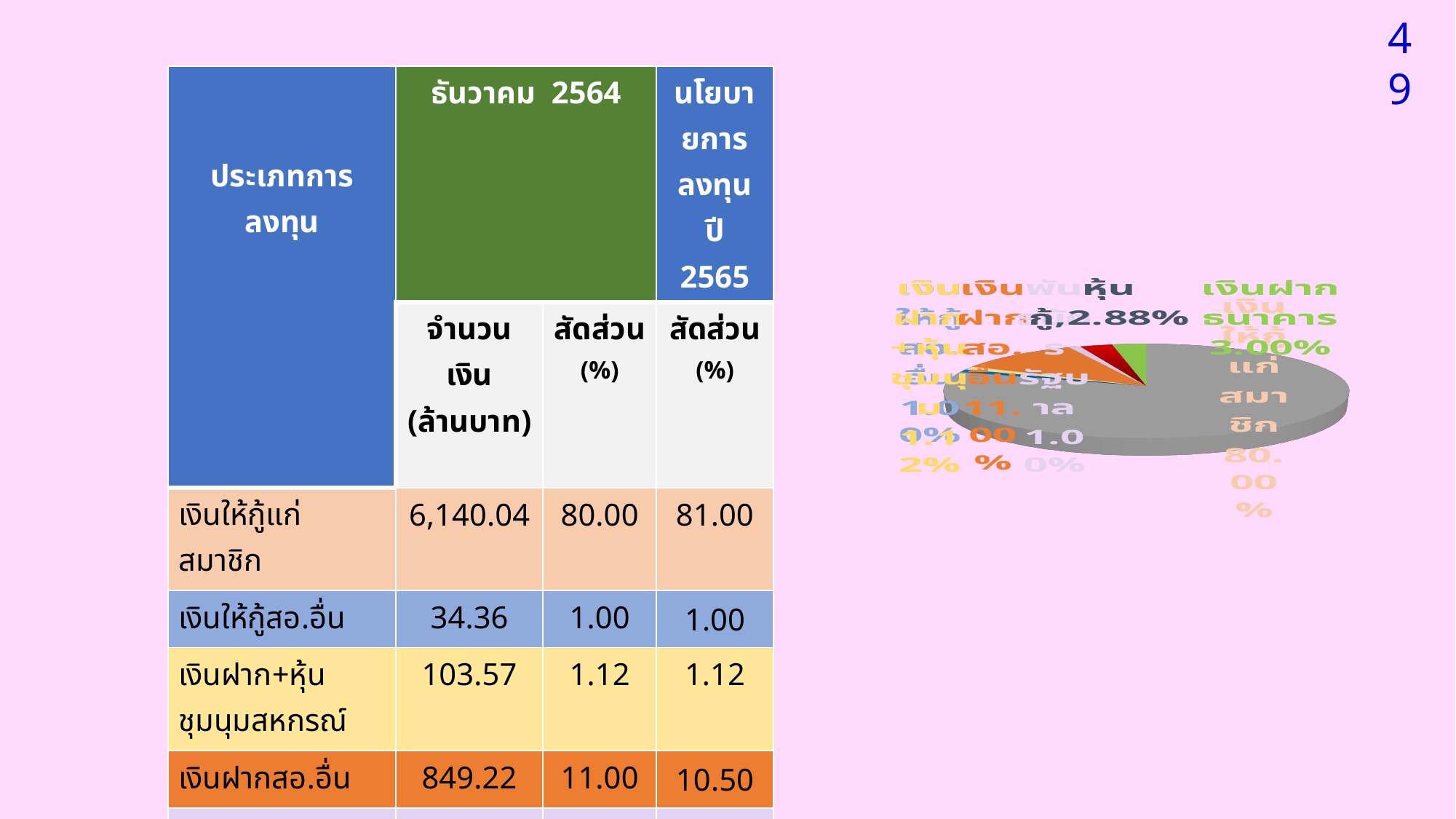
In the pie chart, what share is labelled for หุ้นกู้? 2.88% In the pie chart, what colour is the largest slice? grey In the pie chart, what is the difference between the share for เงินฝากธนาคาร and the share for หุ้นกู้? 0.12% In the pie chart, which is larger: the share for เงินฝากธนาคาร or the share for หุ้นกู้? เงินฝากธนาคาร In the pie chart, what share is labelled for เงินฝากธนาคาร? 3.00% In the pie chart, what share is labelled for เงินให้กู้แก่สมาชิก? 80.00% In the pie chart, which category has the largest slice? เงินให้กู้แก่สมาชิก What kind of chart is shown on the right side of the slide? pie chart